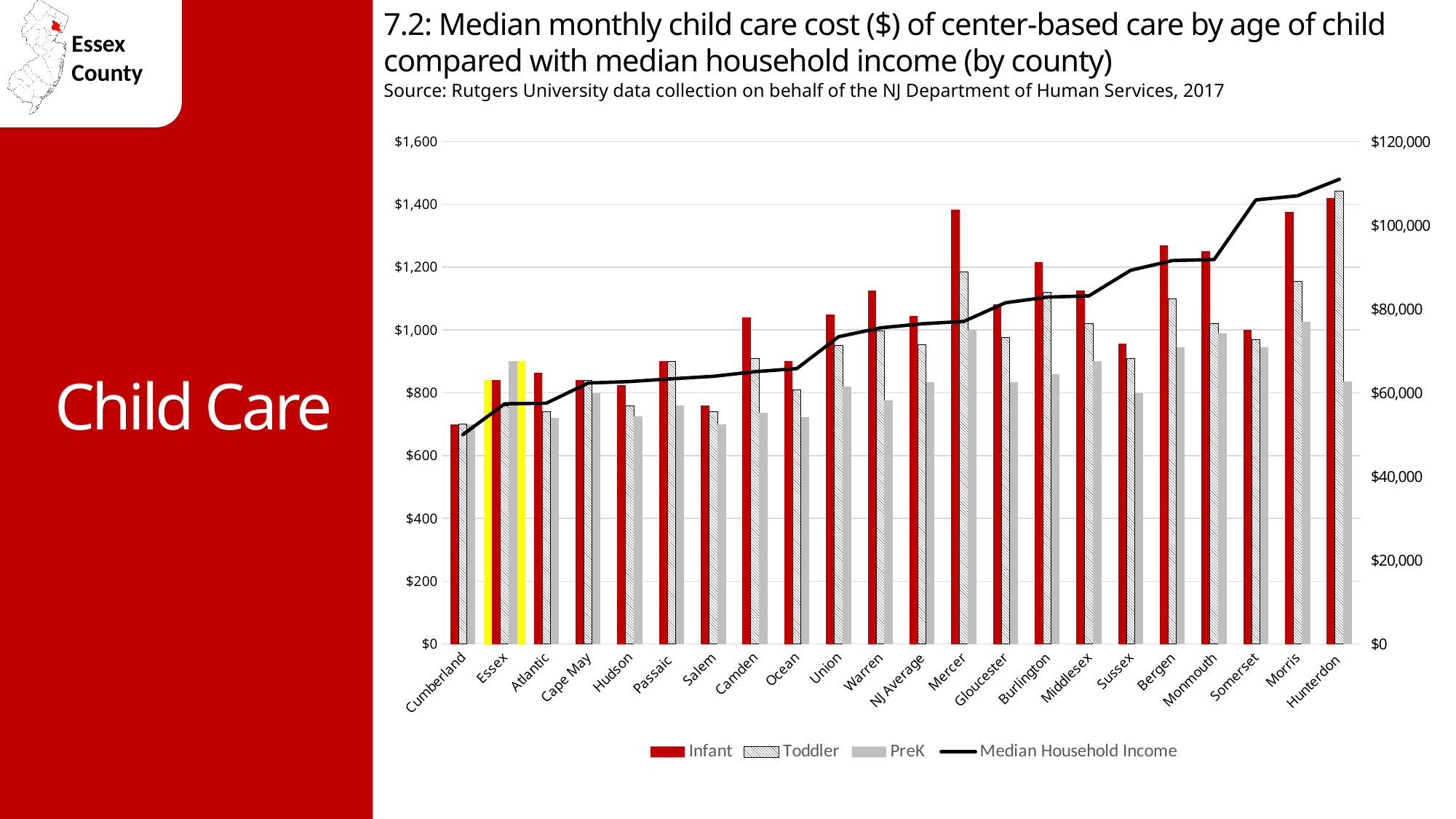
Is the Infant cost for Essex greater or less than $800? greater Which category has the lowest Infant cost? Cumberland Which category has the highest Toddler cost? Hunterdon Is the Median Household Income for Cumberland greater or less than $60,000? less Does the Median Household Income line generally rise or fall from left to right across the x axis? rise Which is larger, the Infant cost for Mercer or the Infant cost for Sussex? Mercer How many counties/categories are shown along the x axis? 22 Is the Infant cost for Cumberland greater or less than $800? less What kind of chart is shown on the slide? Bar chart with a line How many series does the legend list? 4